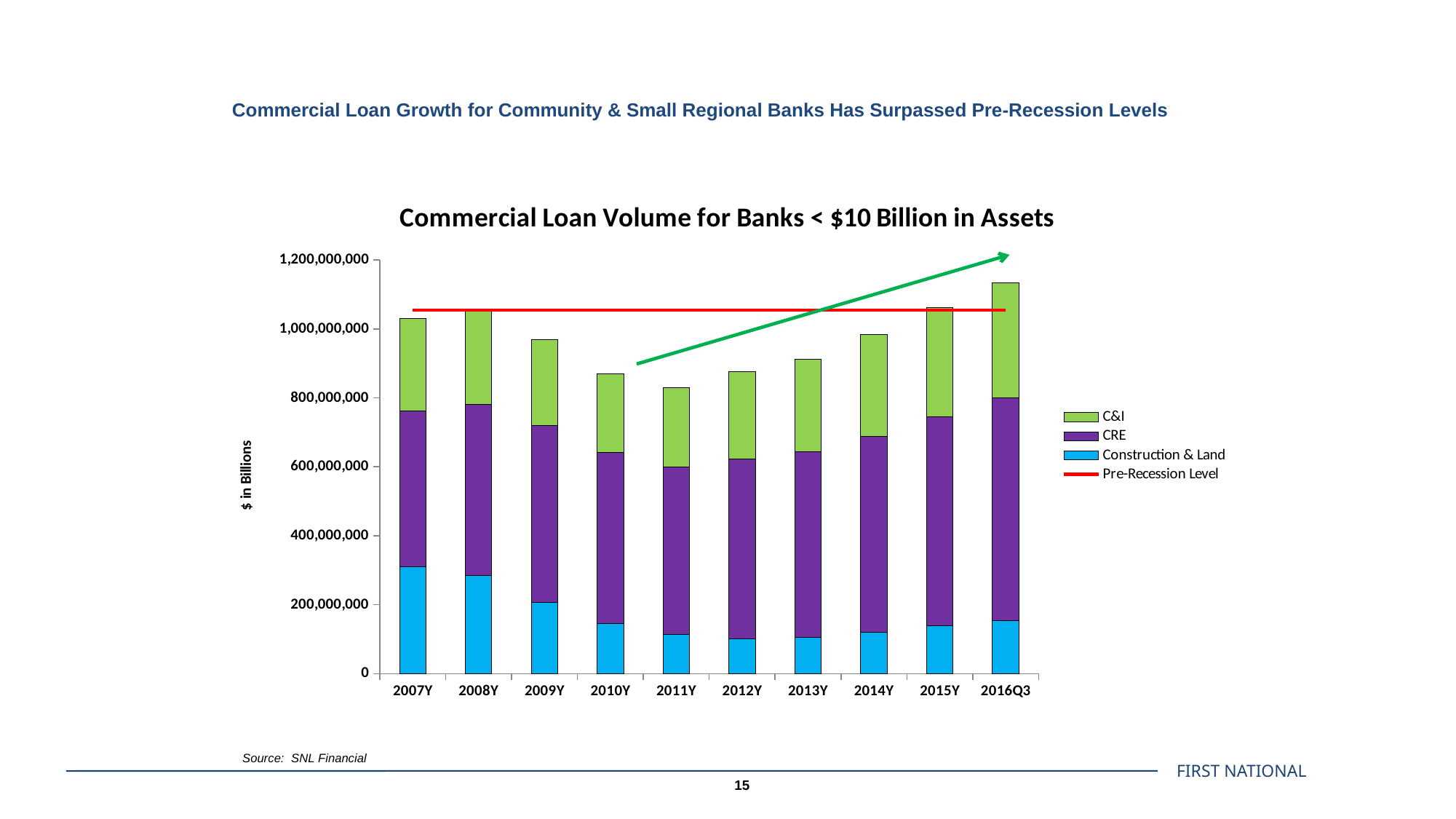
How many entries does the chart's legend list? 4 Which period has the highest total commercial loan volume? 2016Q3 Is the total bar for 2016Q3 greater or less than 1,000,000,000? greater Do the total bars rise or fall from 2011Y to 2016Q3? Rise How many time periods are shown on the x axis of the chart? 10 What kind of chart is shown on the slide? Stacked bar chart Is the Construction & Land value for 2007Y greater or less than 200,000,000? greater Which period has the lowest total commercial loan volume? 2011Y Is the total bar for 2011Y greater or less than 1,000,000,000? less What is the label on the vertical axis of the chart? $ in Billions What is the title of the chart? Commercial Loan Volume for Banks < $10 Billion in Assets Which is larger, the total bar for 2016Q3 or the total bar for 2007Y? 2016Q3